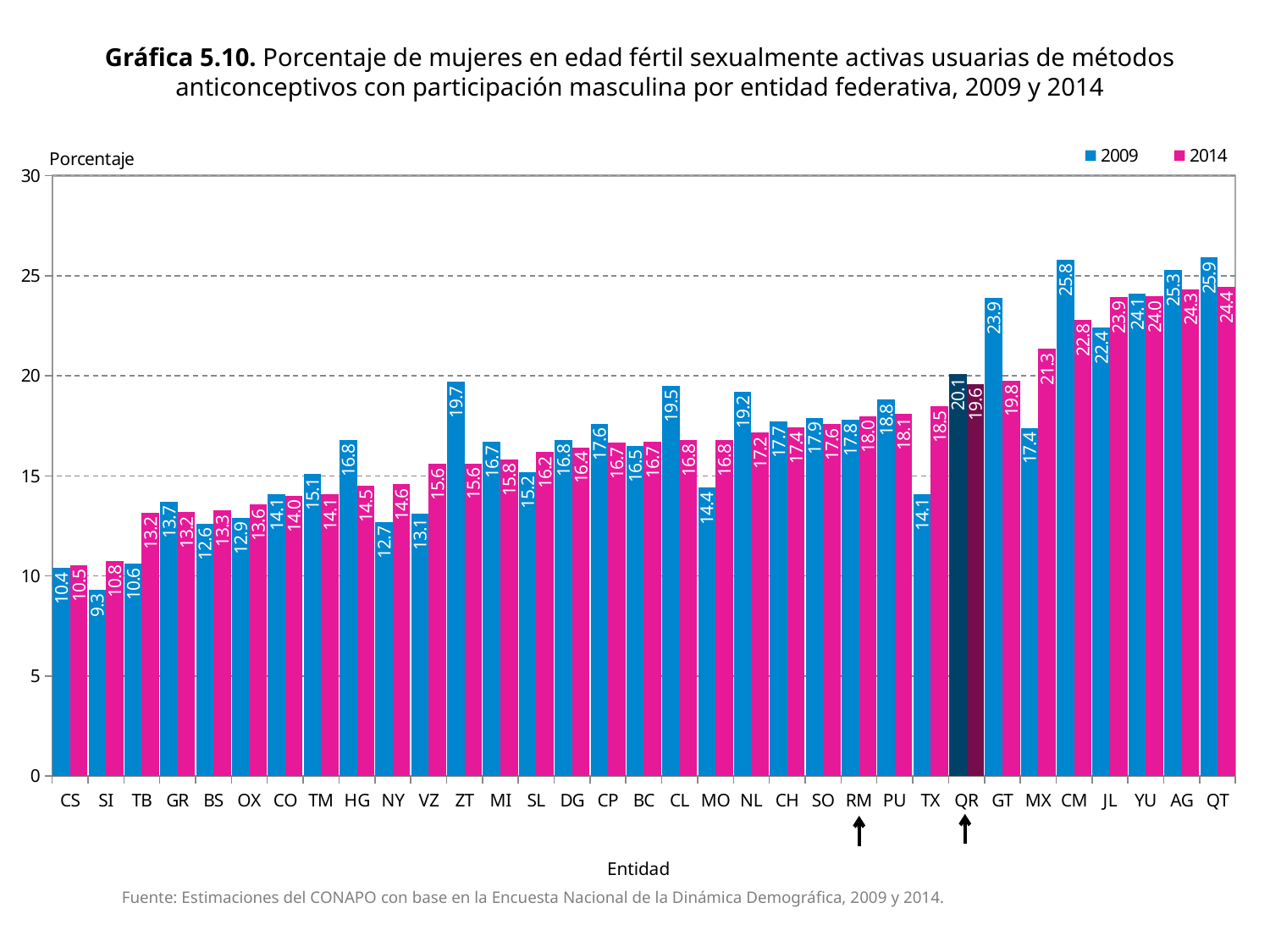
Is the 2009 value for MX greater or less than 20? less Do the 2014 values generally rise or fall from left to right along the x axis? rise What is the 2014 value for QT? 24.4 For GT, which year has the larger value, 2009 or 2014? 2009 Which entity has the highest 2009 value? QT What is the difference between the 2009 and 2014 values for CM? 3.0 What kind of chart is shown? bar chart What is the 2009 value for ZT? 19.7 What is the 2014 value for RM? 18.0 How many series does the legend list? 2 Which entity has the lowest 2009 value? SI Which entity has the lowest 2014 value? CS